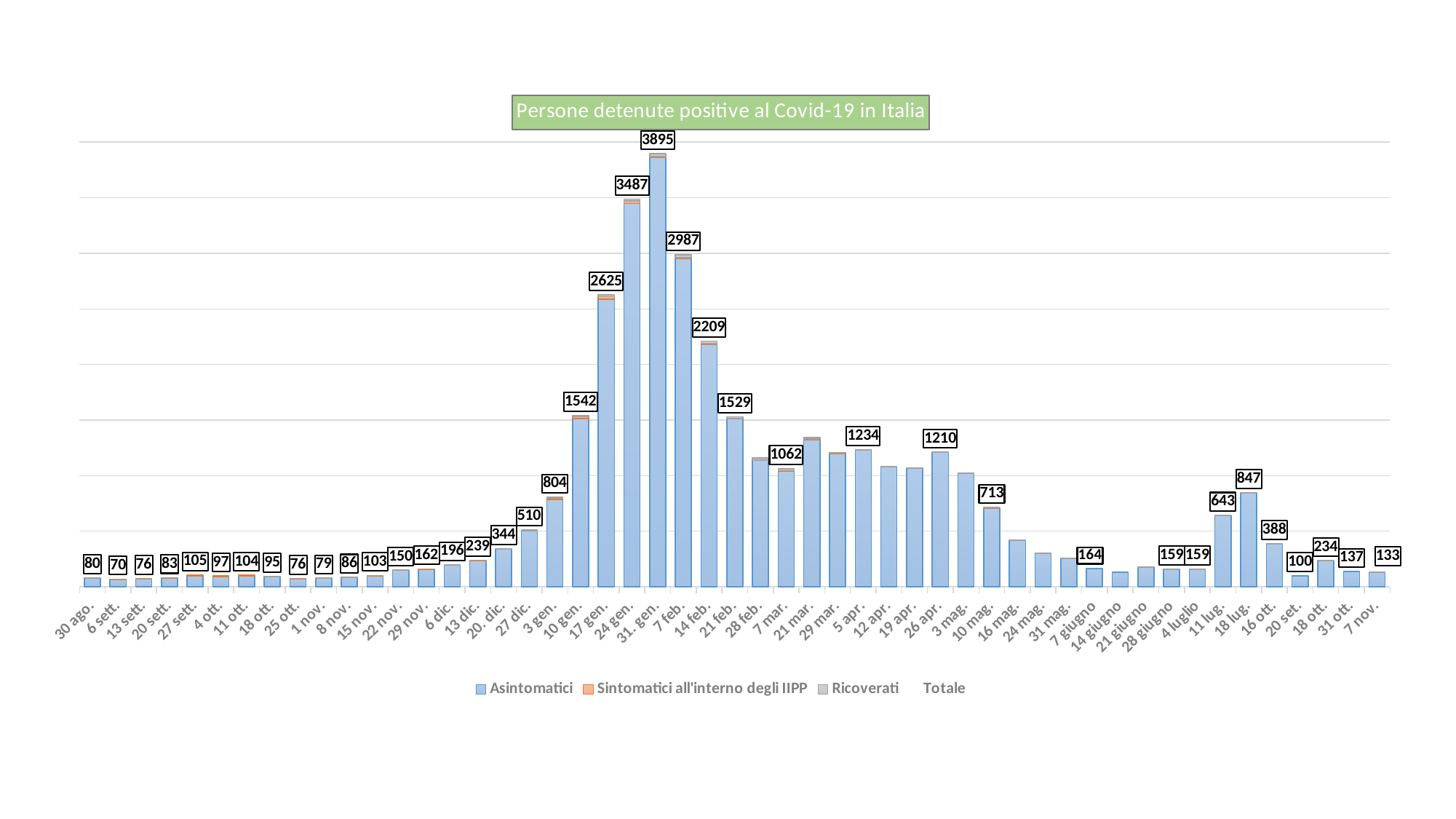
What is the difference between the totals for 31. gen. and 7 feb.? 908 What is the total value labelled for 7 nov.? 133 What is the difference between the totals for 18 lug. and 16 ott.? 459 What is the total value labelled for 31. gen.? 3895 Which is larger, the total for 11 lug. or the total for 18 lug.? 18 lug. Do the totals rise or fall from 22 nov. to 31. gen.? rise How many series does the legend list? 4 What is the title of the chart? Persone detenute positive al Covid-19 in Italia What is the total value labelled for 24 gen.? 3487 What kind of chart is shown on the slide? bar chart Which date has the highest total of positive detainees? 31. gen. Which date has the lowest labelled total? 6 sett.